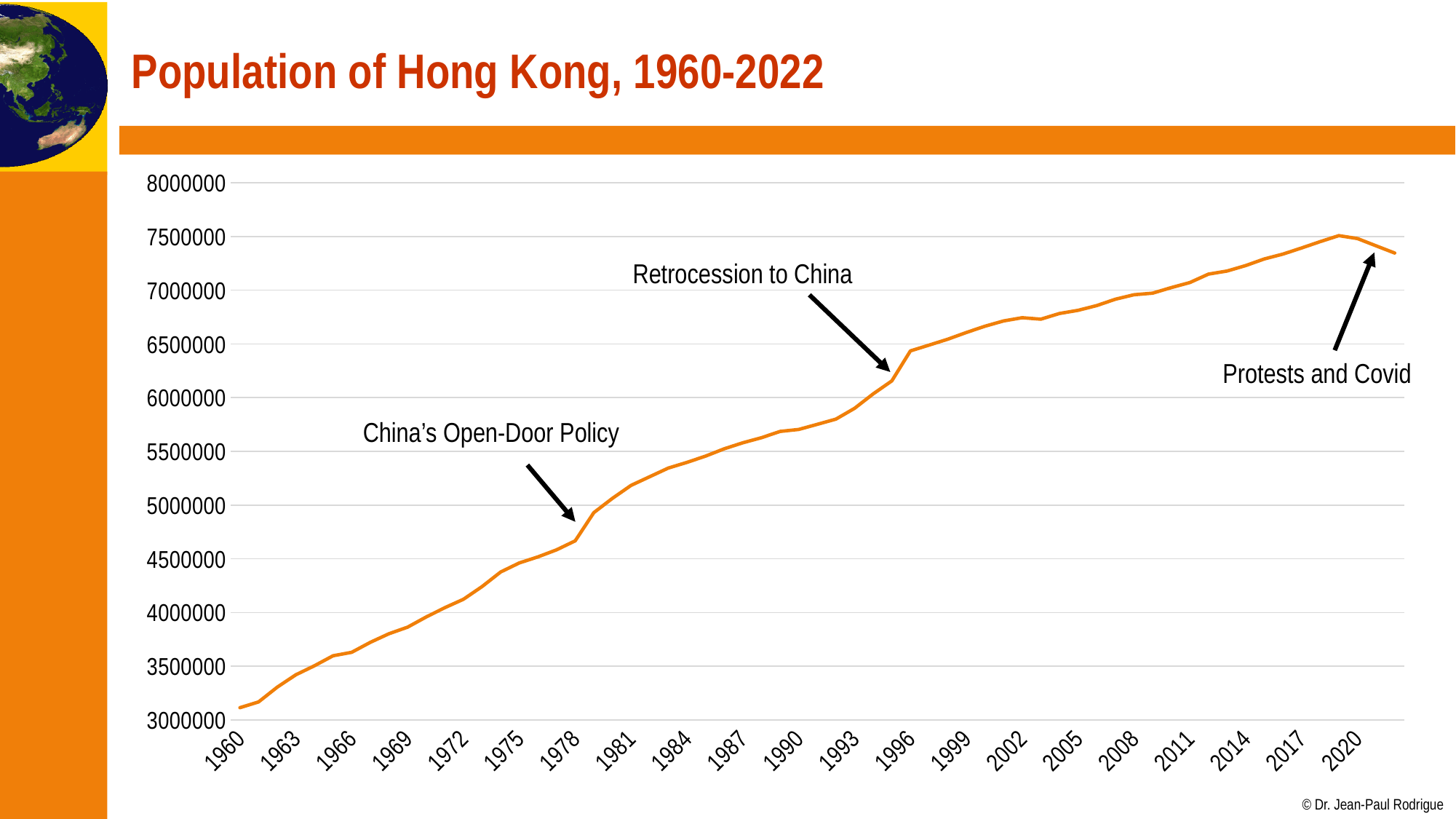
Is the population value for 2017 greater or less than 7500000? less Is the population value for 1978 greater or less than 5000000? less Which year has the larger population, 1975 or 1990? 1990 Is the population value for 2005 greater or less than 6500000? greater What kind of chart is shown on the slide? line chart What is the highest value shown on the vertical axis? 8000000 What event does the annotation near 1997 label? Retrocession to China Overall, does the population rise or fall from 1960 to 2017? rise Which year has the lowest population value on the chart? 1960 What is the title of the chart? Population of Hong Kong, 1960-2022